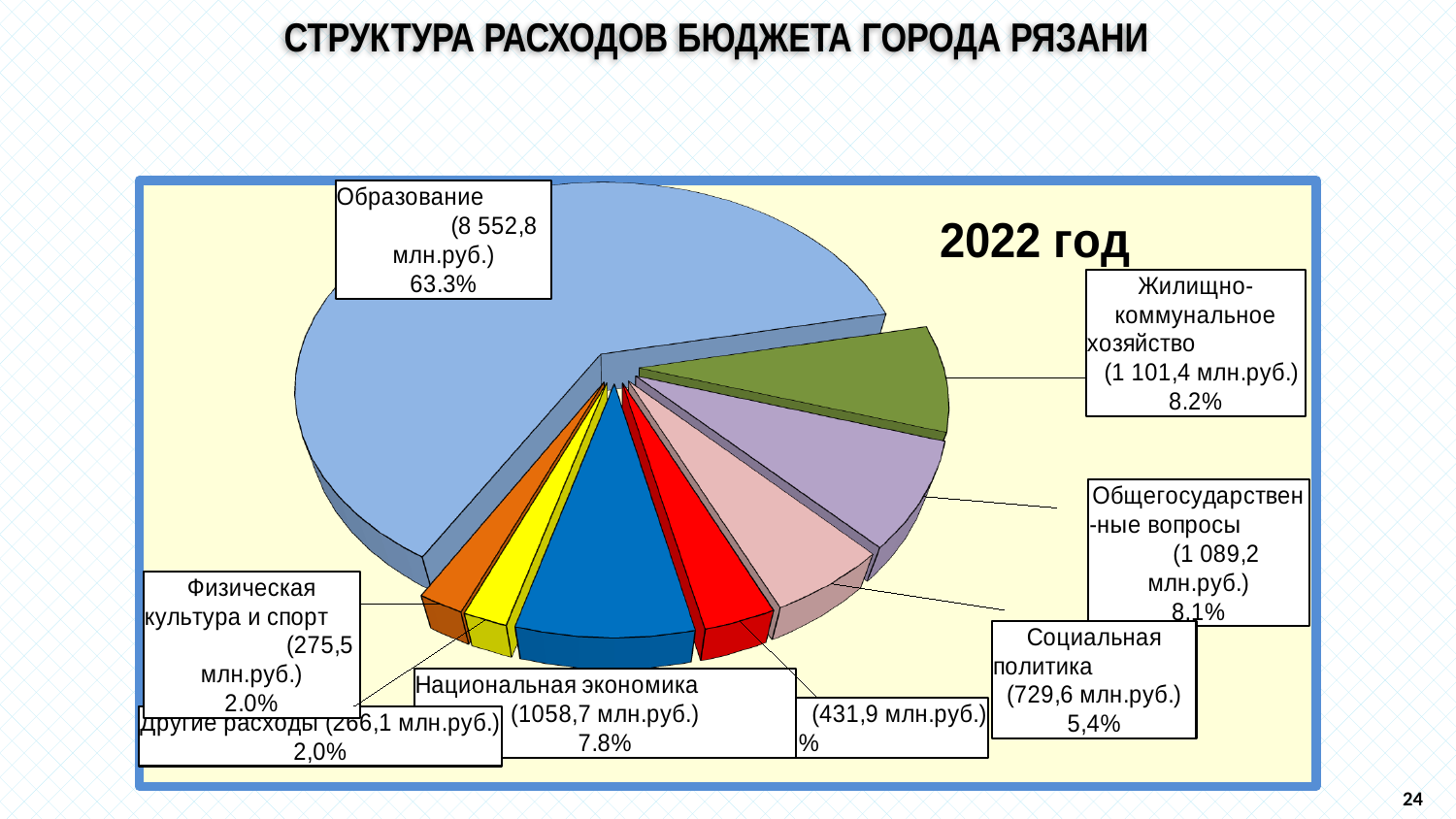
What is the title of the slide? СТРУКТУРА РАСХОДОВ БЮДЖЕТА ГОРОДА РЯЗАНИ What is the amount shown for Физическая культура и спорт? 275,5 млн.руб. Which category has the largest share of the pie? Образование Which year does the chart refer to? 2022 год What is the amount shown for Национальная экономика? 1058,7 млн.руб. What is the difference in percentage points between Жилищно-коммунальное хозяйство (8.2%) and Национальная экономика (7.8%)? 0.4 How many slices does the pie chart have? 8 What is the amount shown for Жилищно-коммунальное хозяйство? 1 101,4 млн.руб. What kind of chart is shown on the slide? pie chart What share of the budget expenditure does Образование account for? 63.3% Which is larger: the share for Жилищно-коммунальное хозяйство or for Общегосударственные вопросы? Жилищно-коммунальное хозяйство What percentage is shown for Социальная политика? 5.4%